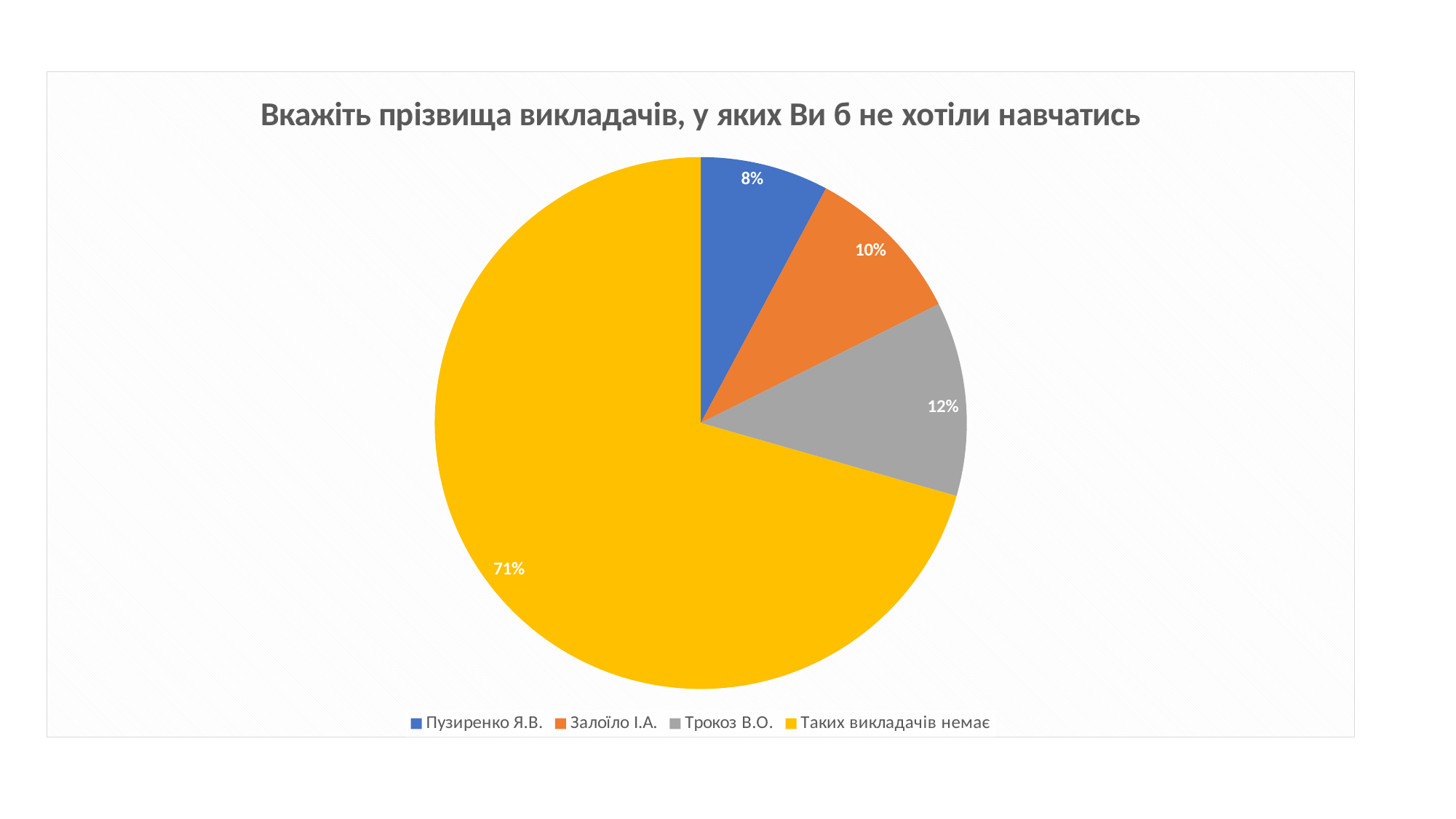
What colour is the slice for Таких викладачів немає? yellow Which category has the largest slice of the pie? Таких викладачів немає How many slices does the pie chart have? 4 What share of the pie is labelled for Таких викладачів немає? 71% What share of the pie is labelled for Залоїло І.А.? 10% Which is larger: the slice for Трокоз В.О. or the slice for Залоїло І.А.? Трокоз В.О. What share of the pie is labelled for Трокоз В.О.? 12% What kind of chart is shown on the slide? pie chart What is the difference between the share for Трокоз В.О. and the share for Пузиренко Я.В.? 4% Which category has the smallest slice of the pie? Пузиренко Я.В. What is the title of the chart? Вкажіть прізвища викладачів, у яких Ви б не хотіли навчатись